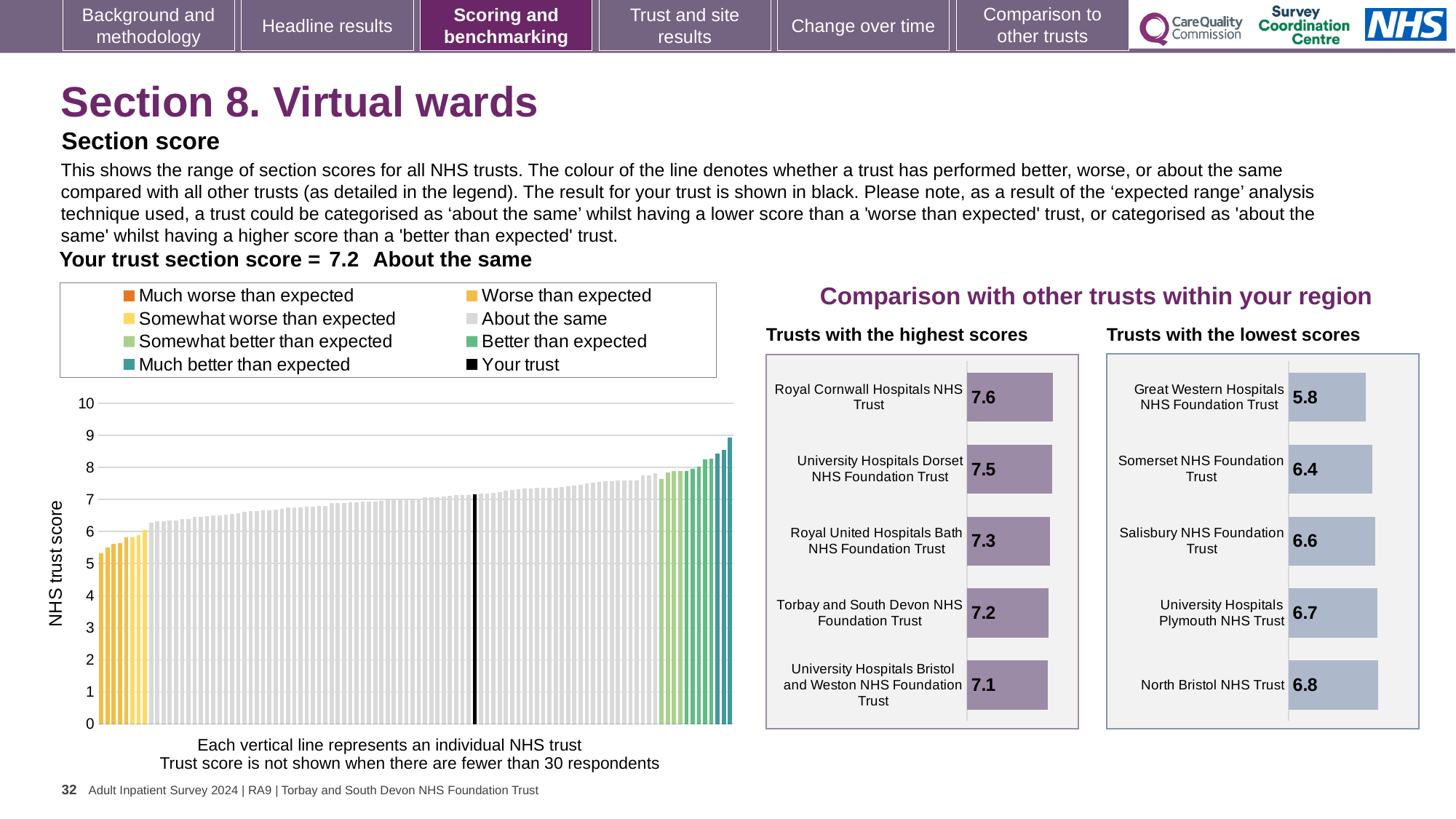
In the 'Trusts with the highest scores' chart, which trust has the lowest score shown? University Hospitals Bristol and Weston NHS Foundation Trust In the 'Trusts with the lowest scores' chart, which has the higher score: Salisbury NHS Foundation Trust or University Hospitals Plymouth NHS Trust? University Hospitals Plymouth NHS Trust In the 'Trusts with the highest scores' chart, what is the difference between the scores of Royal Cornwall Hospitals NHS Trust and Torbay and South Devon NHS Foundation Trust? 0.4 In the 'Trusts with the lowest scores' chart, which trust has the lowest score? Great Western Hospitals NHS Foundation Trust In the 'Trusts with the lowest scores' chart, what is the difference between the scores of North Bristol NHS Trust and Great Western Hospitals NHS Foundation Trust? 1.0 What kind of chart is the NHS trust score chart on the left of the slide? Bar chart How many trusts are shown in the 'Trusts with the highest scores' chart? 5 In the NHS trust score chart on the left, do the values rise or fall from left to right along the x axis? Rise In the 'Trusts with the highest scores' chart, what is the score for Royal Cornwall Hospitals NHS Trust? 7.6 In the 'Trusts with the lowest scores' chart, what is the score for Somerset NHS Foundation Trust? 6.4 In the NHS trust score chart on the left, is the value of the leftmost (lowest) bar greater or less than 6? less How many entries does the legend of the NHS trust score chart on the left list? 8